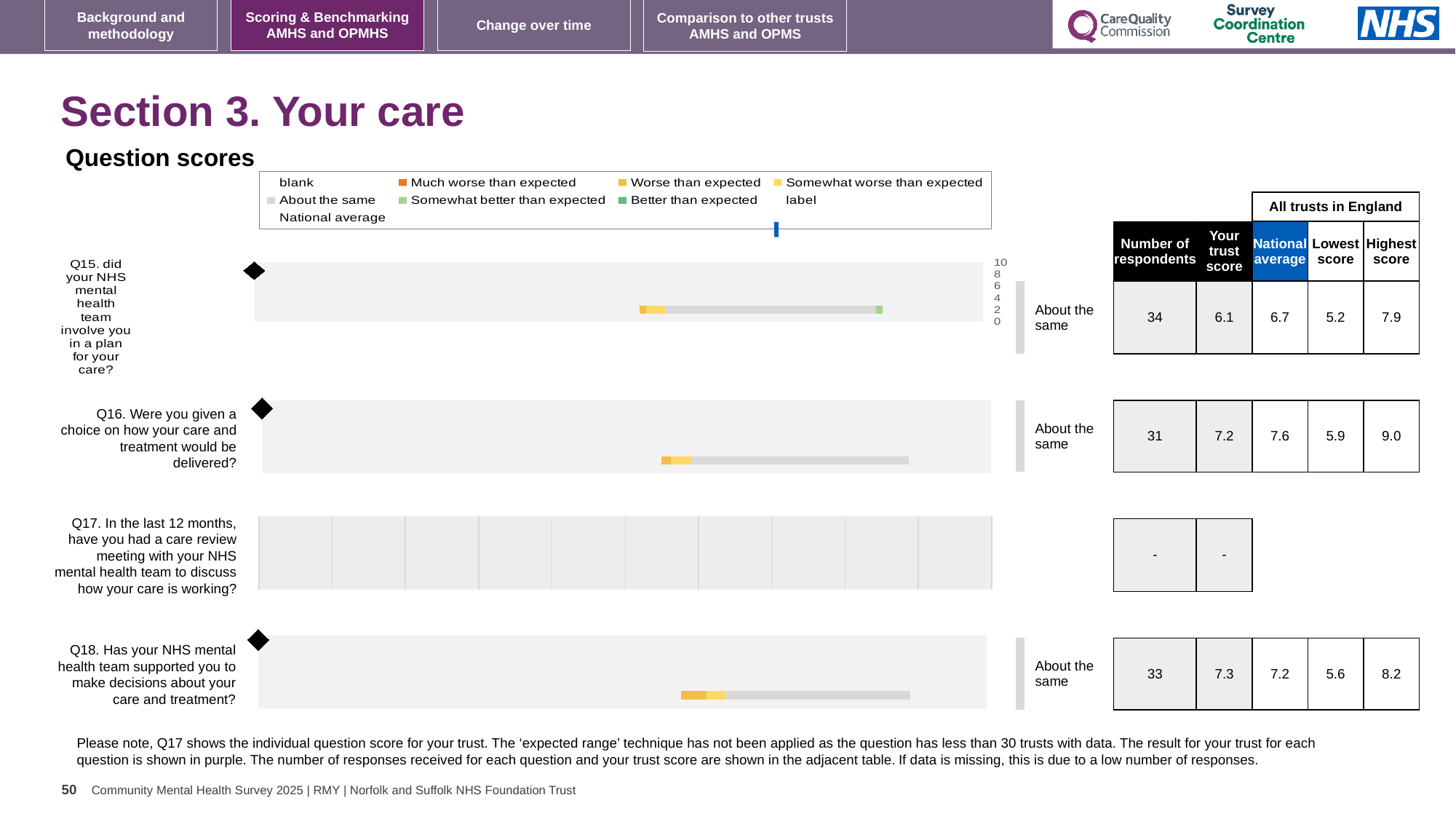
How many questions are plotted in the Question scores chart? 4 For Q15, which is larger: the trust score or the national average? national average What rating label is shown next to the bar for Q18? About the same How many respondents answered Q16 (were you given a choice on how your care and treatment would be delivered)? 31 Which question has the highest trust score? Q18 What kind of chart is used to show the question scores on this slide? bar chart What is the trust score for Q15 (did your NHS mental health team involve you in a plan for your care)? 6.1 Which question has the most respondents? Q15 What is the difference between the highest score and the lowest score for Q16? 3.1 What is the national average score for Q18 (has your NHS mental health team supported you to make decisions about your care and treatment)? 7.2 What is the highest score among all trusts in England for Q16? 9.0 What is the difference between the national average and the trust score for Q15? 0.6